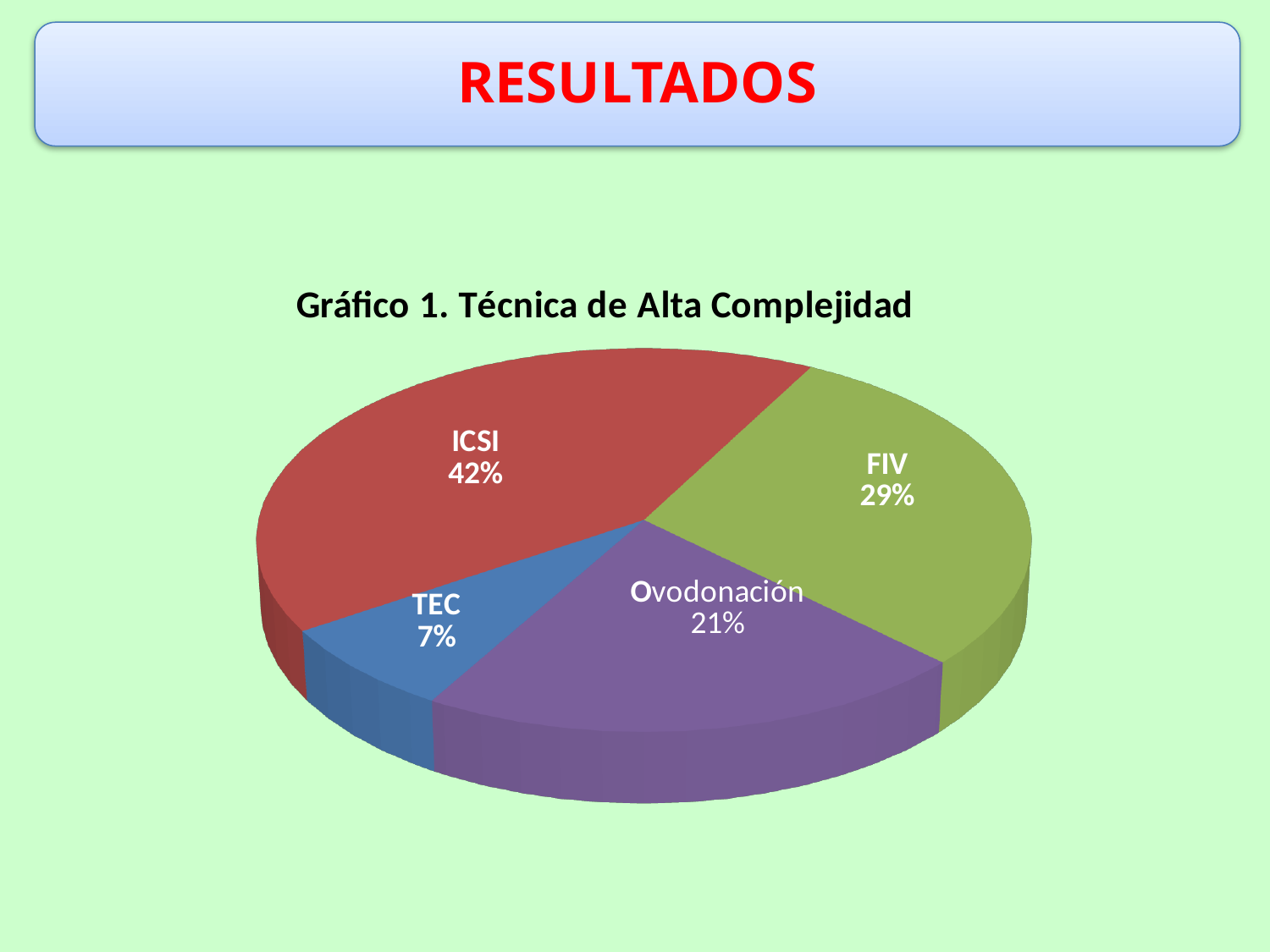
What type of chart is shown on the slide? Pie chart What percentage does the TEC slice represent? 7% What percentage does the FIV slice represent? 29% Which is larger, the share for FIV or the share for Ovodonación? FIV What is the difference in percentage points between ICSI and FIV? 13 Which technique has the smallest share of the pie? TEC How many slices does the pie chart have? 4 What percentage does the Ovodonación slice represent? 21% Which technique has the largest share of the pie? ICSI What is the title of the chart? Gráfico 1. Técnica de Alta Complejidad What percentage does the ICSI slice represent? 42% What colour is the ICSI slice? Red